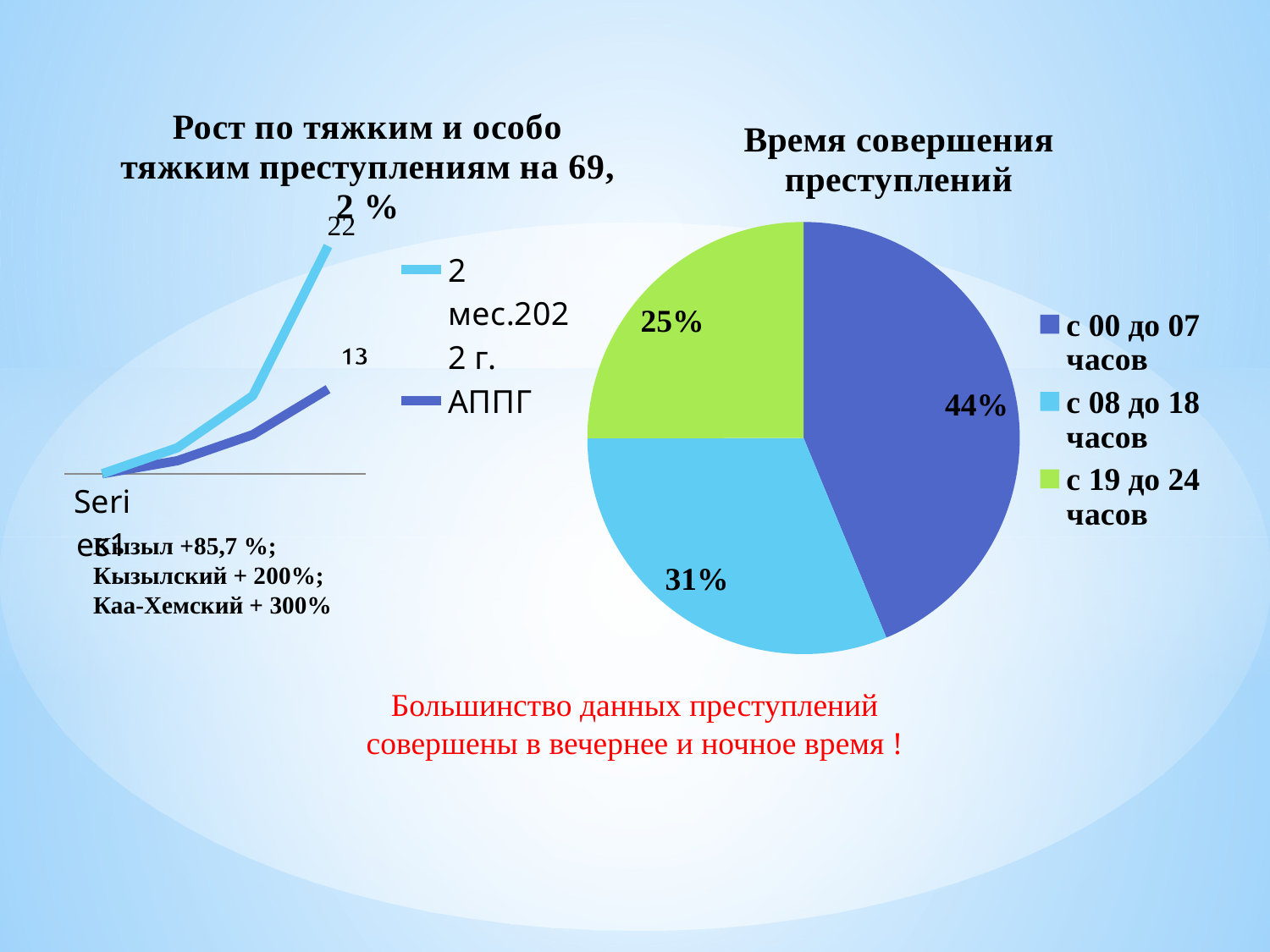
In the pie chart 'Время совершения преступлений', which is larger: the slice for 'с 08 до 18 часов' or the slice for 'с 19 до 24 часов'? с 08 до 18 часов In the pie chart 'Время совершения преступлений', how many percentage points larger is the 'с 00 до 07 часов' slice than the 'с 19 до 24 часов' slice? 19 percentage points In the pie chart 'Время совершения преступлений', what share is shown for 'с 00 до 07 часов'? 44% In the pie chart 'Время совершения преступлений', which time period has the largest slice? с 00 до 07 часов In the pie chart 'Время совершения преступлений', which time period has the smallest slice? с 19 до 24 часов How many slices does the pie chart 'Время совершения преступлений' have? 3 In the left chart 'Рост по тяжким и особо тяжким преступлениям на 69,2 %', what is the difference between the final labelled values of the two series (22 and 13)? 9 In the pie chart 'Время совершения преступлений', what share is shown for 'с 19 до 24 часов'? 25% What kind of chart is the chart on the left of the slide, titled 'Рост по тяжким и особо тяжким преступлениям на 69,2 %'? Line chart How many series does the legend of the left chart 'Рост по тяжким и особо тяжким преступлениям на 69,2 %' list? 2 What kind of chart is the chart on the right of the slide? Pie chart In the pie chart 'Время совершения преступлений', what share is shown for 'с 08 до 18 часов'? 31%